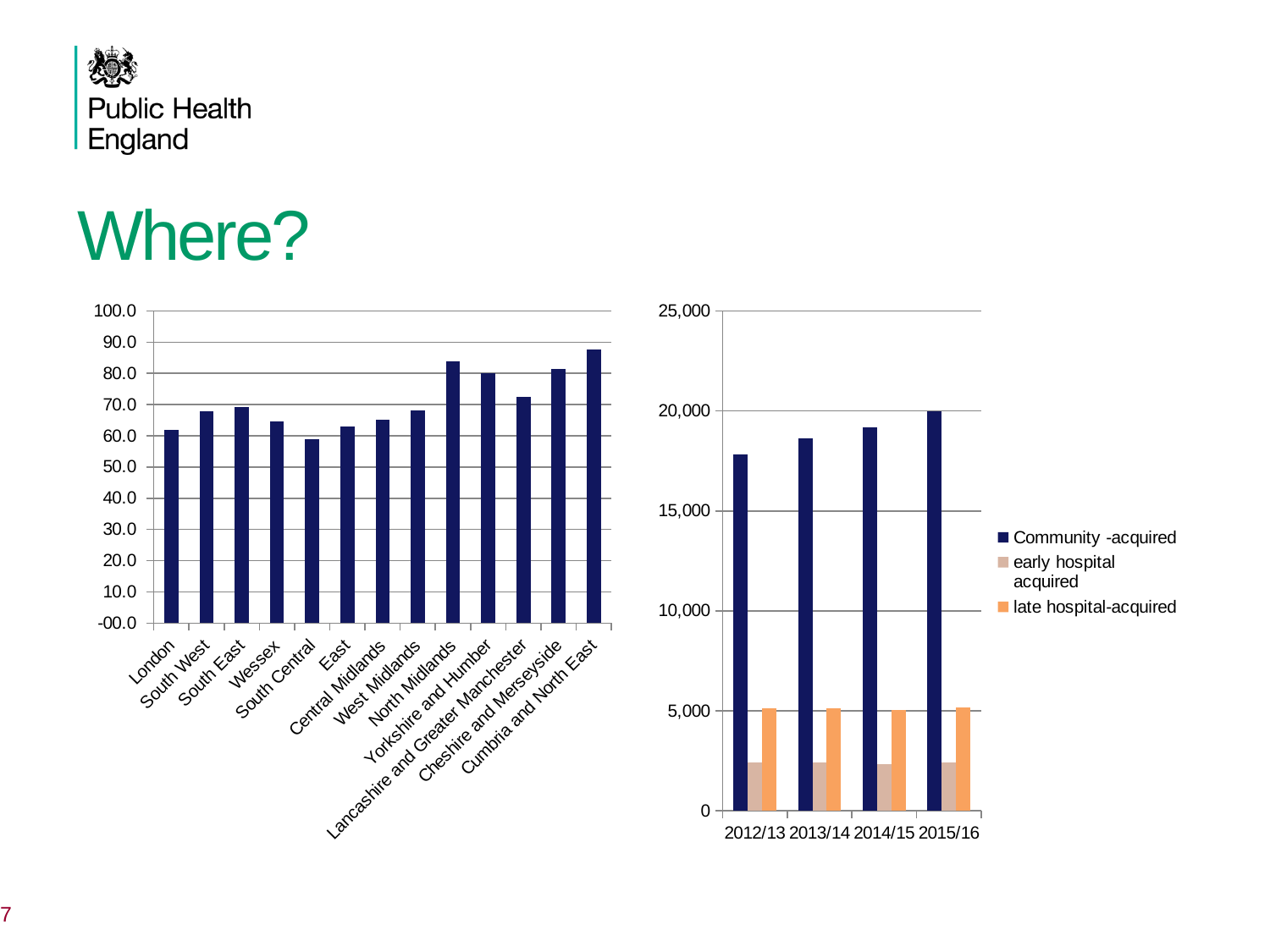
On the left chart, is the value for North Midlands greater or less than 80.0? greater On the right chart, how many years are shown on the x axis? 4 On the right chart, does the Community -acquired series rise or fall from 2012/13 to 2015/16? rise What kind of chart is the left chart? bar chart On the left chart, how many regions are shown on the x axis? 13 On the right chart, which is larger in 2012/13, early hospital acquired or late hospital-acquired? late hospital-acquired On the left chart, which region has the highest value? Cumbria and North East On the right chart, how many series does the legend list? 3 On the left chart, which region has the lowest value? South Central On the left chart, which is larger, the value for Yorkshire and Humber or the value for East? Yorkshire and Humber On the left chart, is the value for South Central greater or less than 70.0? less On the right chart, is the Community -acquired value for 2012/13 greater or less than 20,000? less